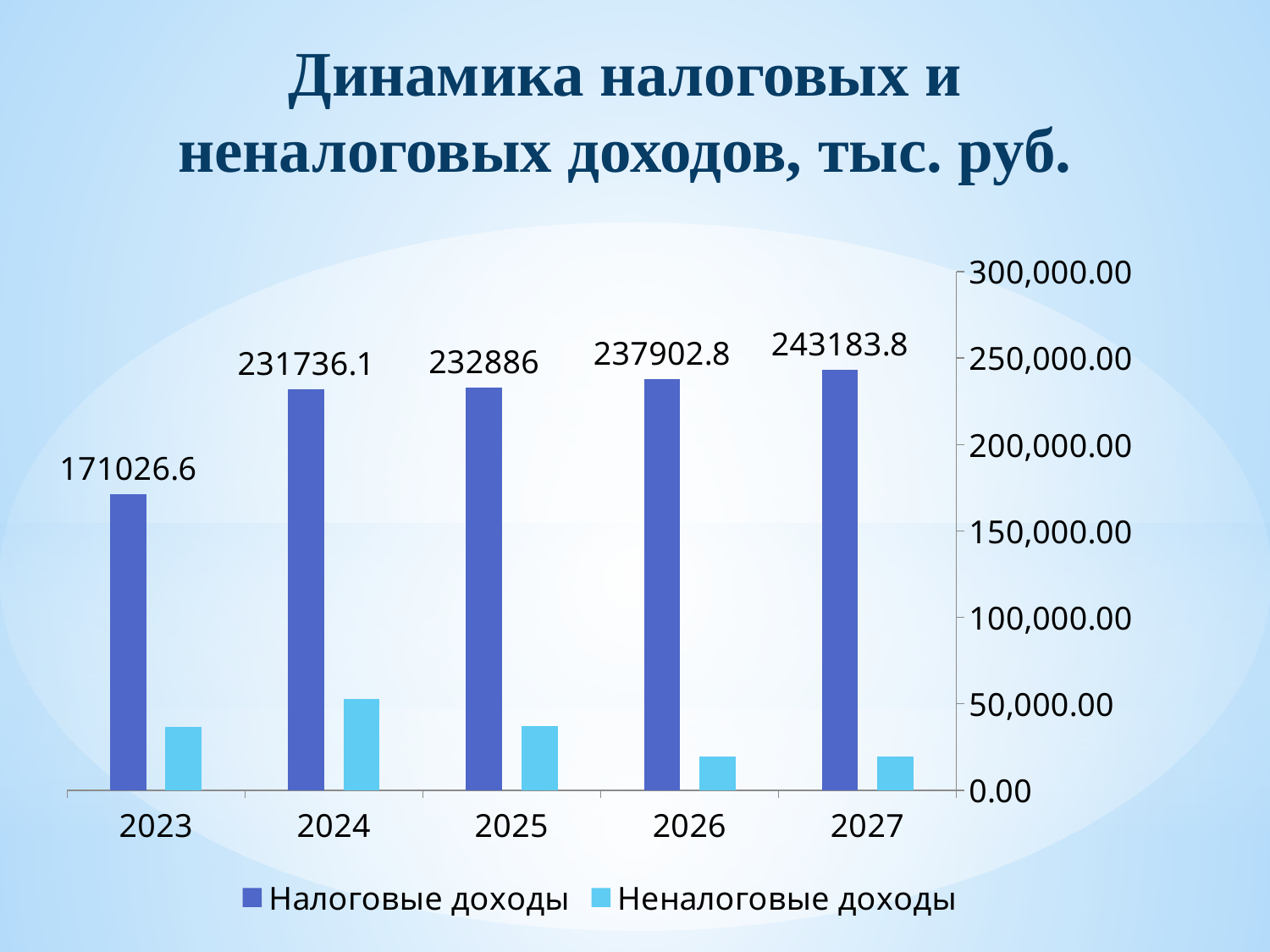
What is the difference between Налоговые доходы in 2026 and in 2025? 5016.8 Is the value of Неналоговые доходы for 2026 greater or less than 50,000.00? less In which year is Налоговые доходы the highest? 2027 What is the value of Налоговые доходы for 2023? 171026.6 How many years are shown on the x axis? 5 Which is larger: Неналоговые доходы in 2024 or in 2026? 2024 What is the difference between Налоговые доходы in 2027 and in 2023? 72157.2 What is the value of Налоговые доходы for 2025? 232886 What is the value of Налоговые доходы for 2027? 243183.8 How many series does the legend list? 2 In which year is Налоговые доходы the lowest? 2023 Do the values of Налоговые доходы rise or fall from 2023 to 2027? rise